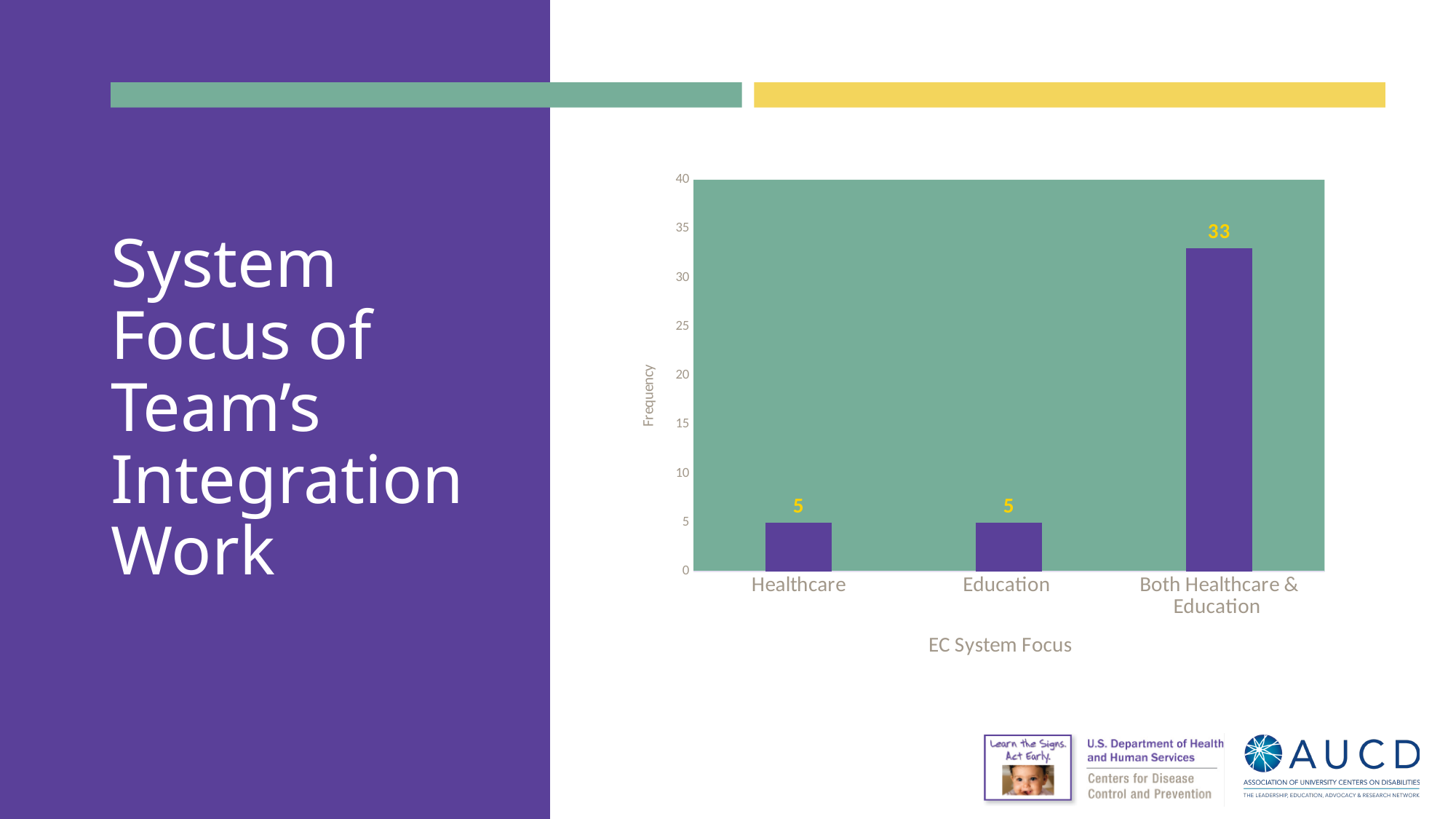
Which has a larger frequency, Education or Both Healthcare & Education? Both Healthcare & Education What is the label of the x axis? EC System Focus What is the frequency for Healthcare? 5 What kind of chart is shown on the slide? bar chart Which EC system focus has the highest frequency? Both Healthcare & Education What is the label of the y axis? Frequency Is the frequency for Both Healthcare & Education greater or less than 30? greater Is the frequency for Healthcare greater or less than 10? less What is the frequency for Education? 5 What is the frequency for Both Healthcare & Education? 33 What is the difference in frequency between Both Healthcare & Education and Healthcare? 28 How many categories are shown on the x axis? 3